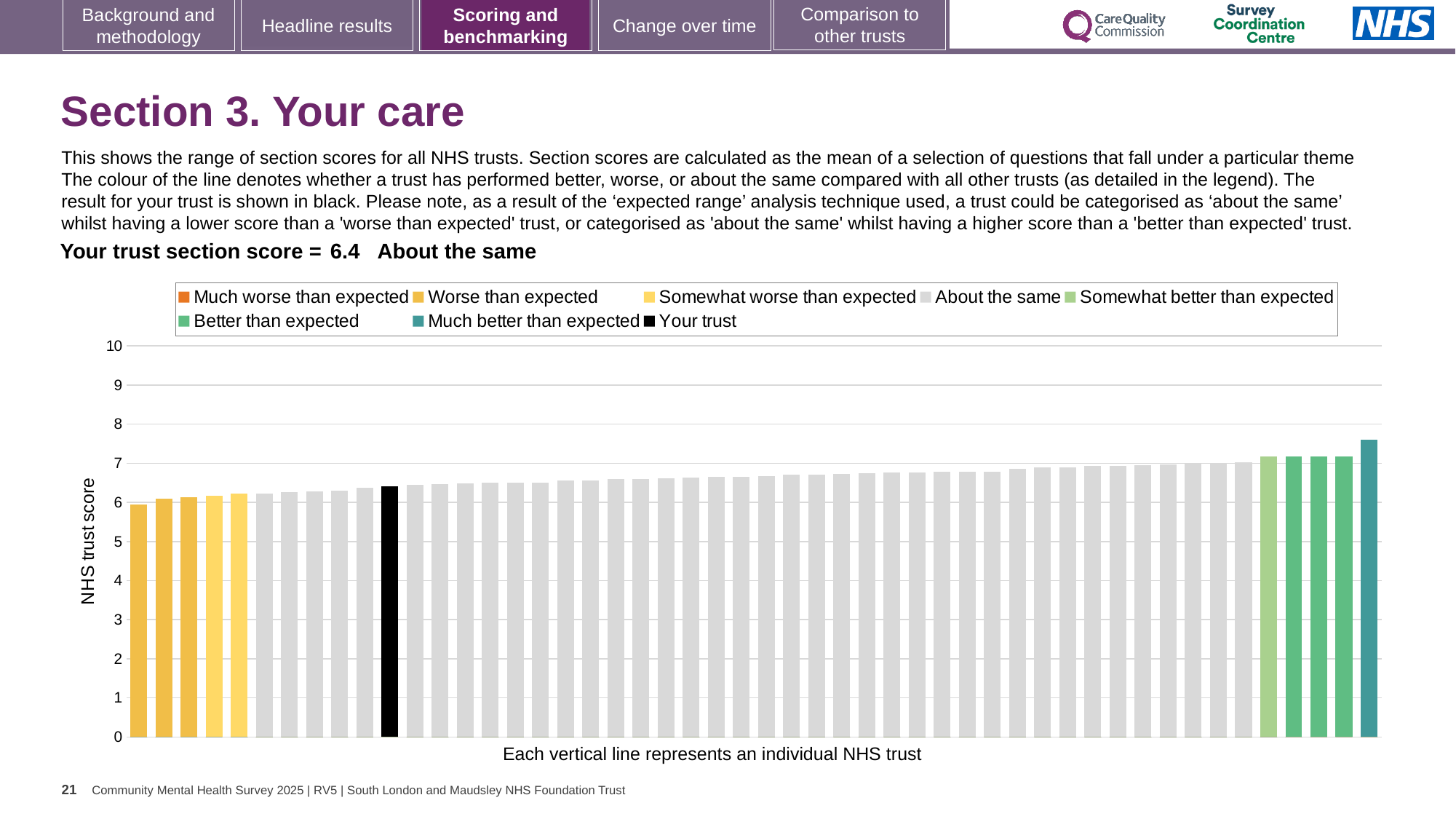
How many bars are coloured as 'Much better than expected' (teal)? 1 What colour is the bar representing your trust? black What kind of chart is shown on the slide? bar chart Is the value of the tallest bar greater or less than 7? greater Is the value for your trust (the black bar) greater or less than 6? greater How many entries does the chart legend list? 8 Is the value of the tallest bar greater or less than 8? less Which category is your trust placed in for this section score? About the same What is the title of the vertical axis? NHS trust score What is the section score for your trust shown on the slide? 6.4 Do the bar values rise or fall from left to right along the x axis? rise